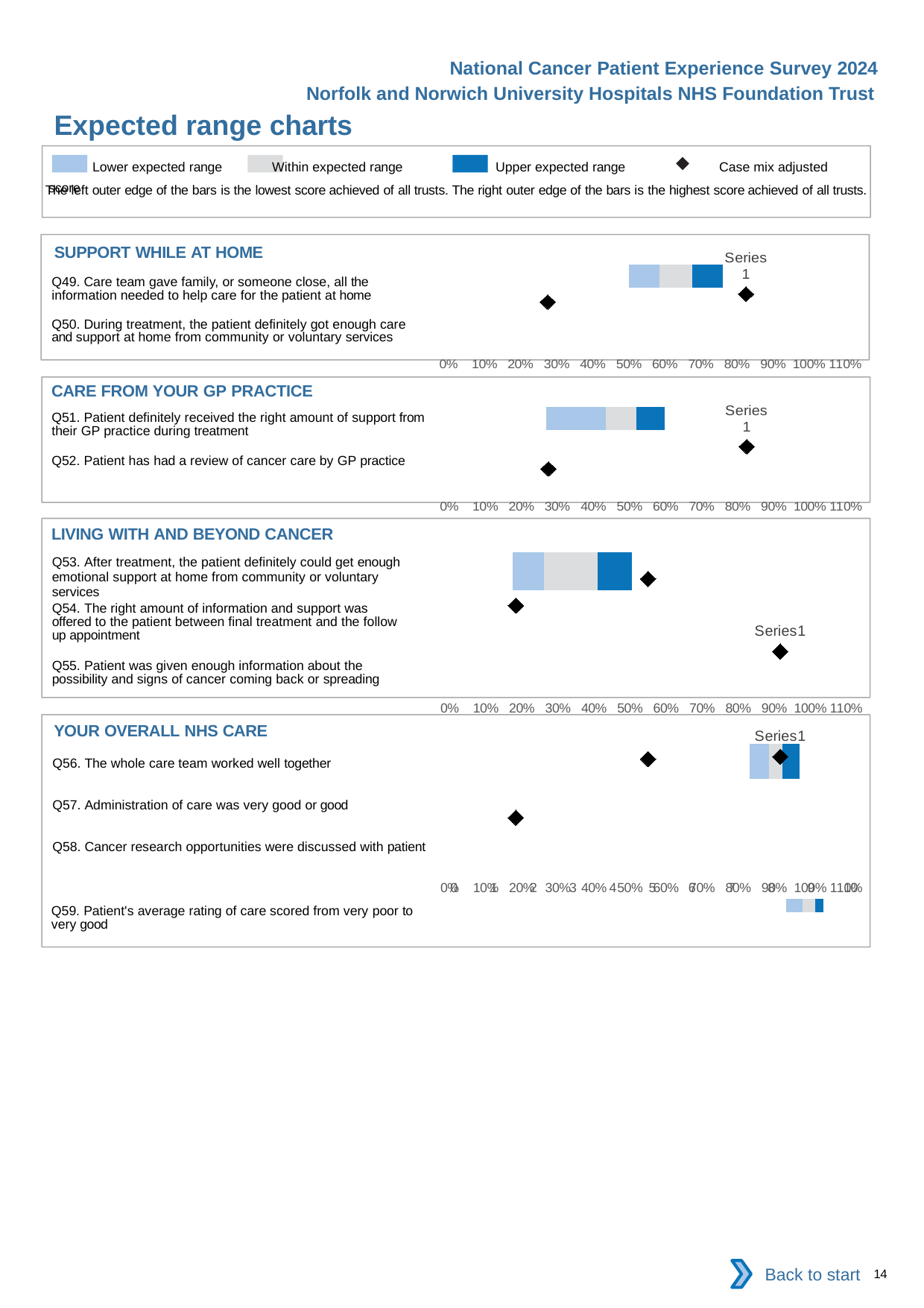
How many chart sections are shown on the slide? 4 How many questions are listed in the SUPPORT WHILE AT HOME chart? 2 In the LIVING WITH AND BEYOND CANCER chart, is the case mix adjusted score for Q53 greater or less than 50%? greater How many entries does the legend at the top of the slide list? 4 What is the highest percentage tick shown on the x axis of the charts? 110% What kind of chart is used in the SUPPORT WHILE AT HOME section? bar chart How many questions are listed in the LIVING WITH AND BEYOND CANCER chart? 3 In the LIVING WITH AND BEYOND CANCER chart, is the case mix adjusted score for Q54 greater or less than 30%? less According to the legend, what does the diamond marker represent? Case mix adjusted score